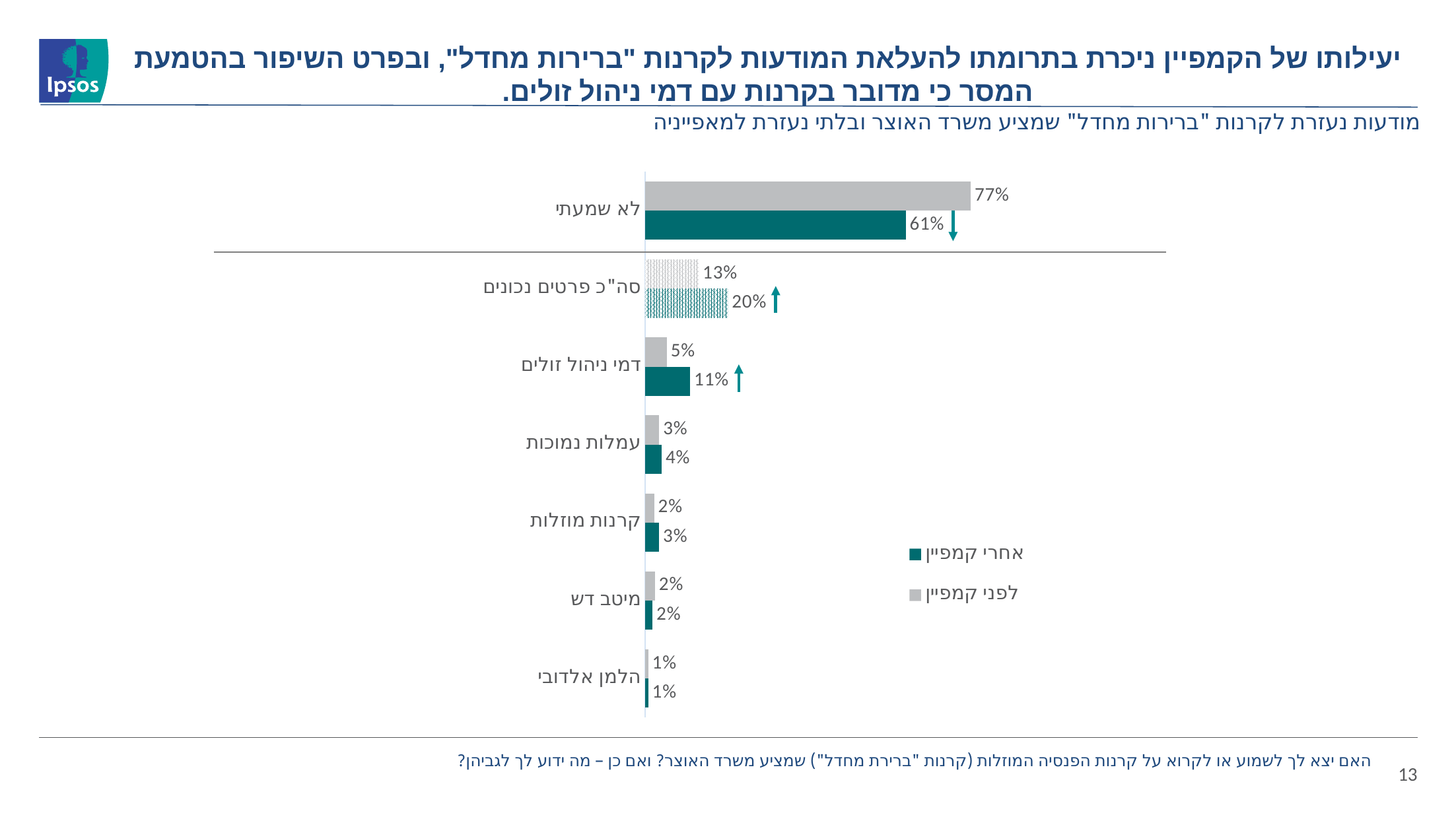
How many series does the legend list? 2 Which category has the highest value in the "אחרי קמפיין" series? לא שמעתי What kind of chart is shown on the slide? Bar chart What is the difference between the "אחרי קמפיין" and "לפני קמפיין" values for "סה"כ פרטים נכונים"? 7% What is the value for "סה"כ פרטים נכונים" in the "לפני קמפיין" series? 13% Which colour represents the "אחרי קמפיין" series in the legend? Teal (dark green) What is the value for "לא שמעתי" in the "לפני קמפיין" series? 77% How many categories are shown on the chart? 7 What is the difference between the "לפני קמפיין" and "אחרי קמפיין" values for "לא שמעתי"? 16% For "דמי ניהול זולים", which series has the larger value, "לפני קמפיין" or "אחרי קמפיין"? אחרי קמפיין What is the value for "לא שמעתי" in the "אחרי קמפיין" series? 61% What is the value for "דמי ניהול זולים" in the "אחרי קמפיין" series? 11%